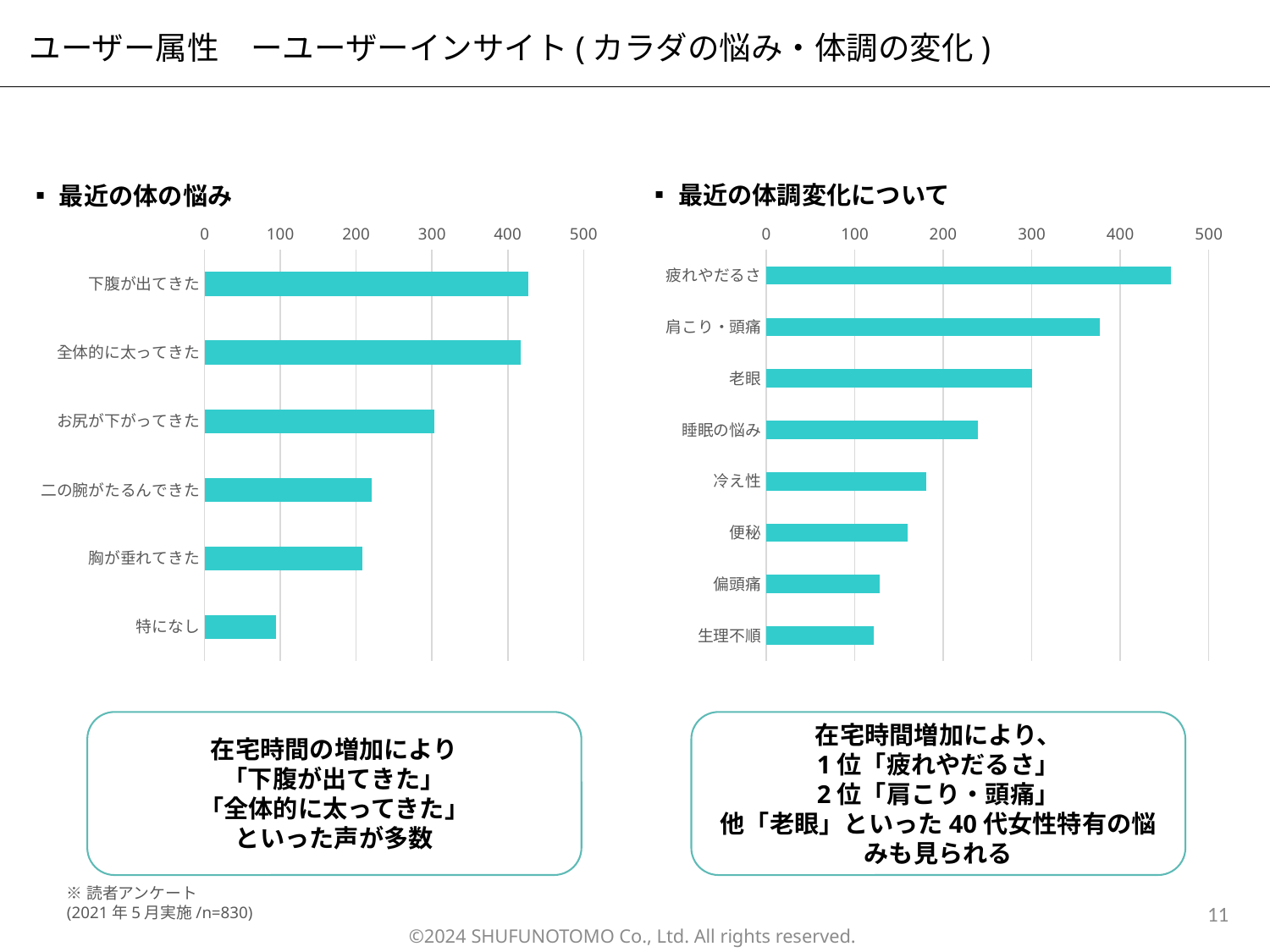
In the '最近の体の悩み' chart, which is larger: お尻が下がってきた or 二の腕がたるんできた? お尻が下がってきた In the '最近の体の悩み' chart, is the value for 下腹が出てきた greater or less than 400? greater What kind of chart is the '最近の体の悩み' chart? bar chart What is the title of the chart on the right side of the slide? 最近の体調変化について In the '最近の体調変化について' chart, which is larger: 冷え性 or 偏頭痛? 冷え性 How many categories are shown in the '最近の体の悩み' chart? 6 In the '最近の体の悩み' chart, which category has the lowest value? 特になし In the '最近の体調変化について' chart, is the value for 肩こり・頭痛 greater or less than 400? less How many categories are shown in the '最近の体調変化について' chart? 8 In the '最近の体調変化について' chart, which category has the highest value? 疲れやだるさ In the '最近の体調変化について' chart, is the value for 睡眠の悩み greater or less than 200? greater